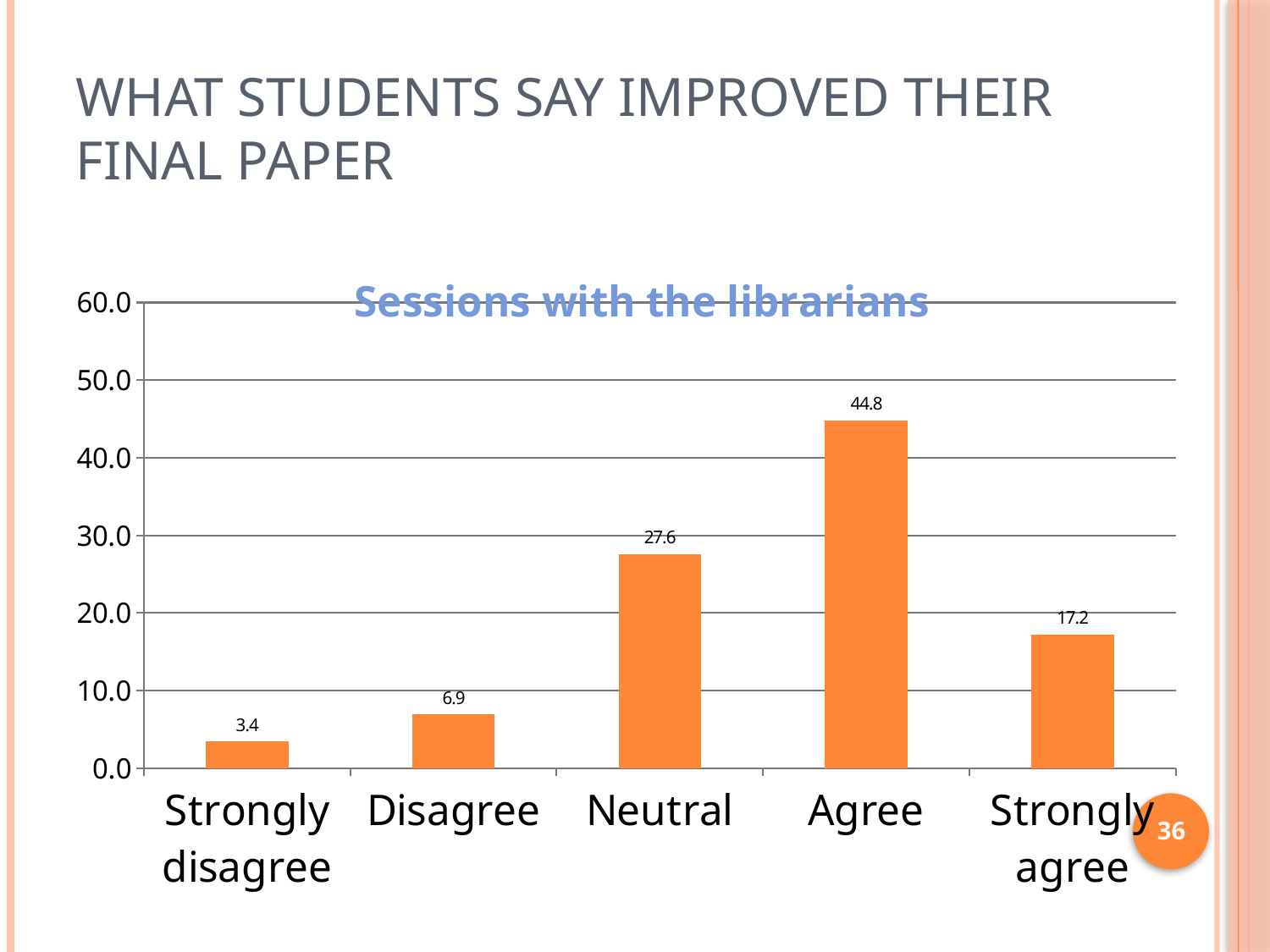
Which is larger, the value for Neutral or the value for Strongly agree? Neutral Which category has the lowest value? Strongly disagree What kind of chart is shown on the slide? Bar chart What is the difference between the values for Disagree and Strongly disagree? 3.5 What is the value for Strongly agree? 17.2 What is the difference between the values for Agree and Neutral? 17.2 What is the value for Strongly disagree? 3.4 What is the value for Agree? 44.8 What is the title of the chart? Sessions with the librarians How many categories are shown on the x axis? 5 Which category has the highest value? Agree What is the value for Neutral? 27.6